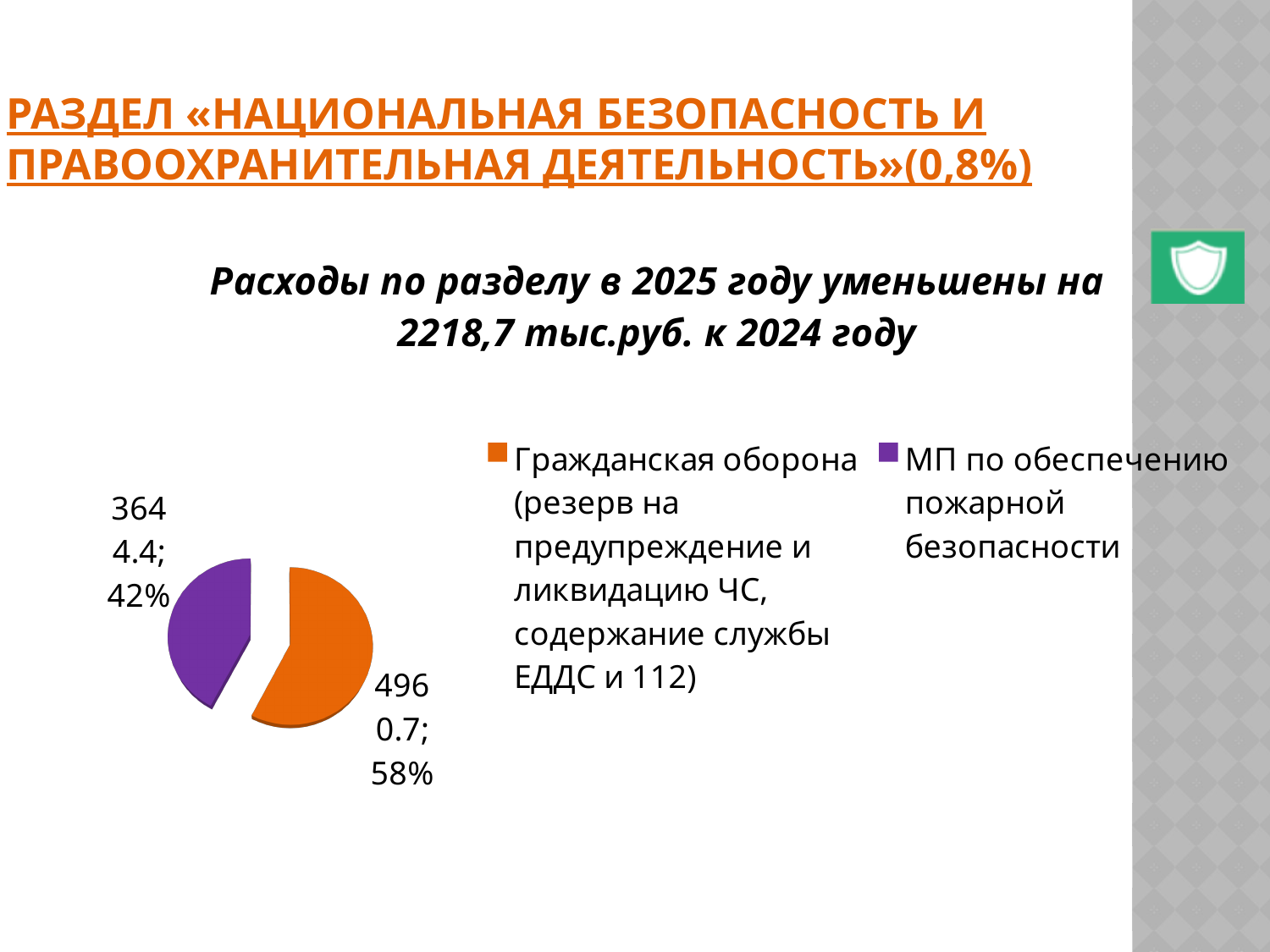
Which is larger: the value for 'Гражданская оборона' or for 'МП по обеспечению пожарной безопасности'? Гражданская оборона What value is shown for the slice 'Гражданская оборона (резерв на предупреждение и ликвидацию ЧС, содержание службы ЕДДС и 112)'? 4960.7 Which slice of the pie chart is the largest? Гражданская оборона (резерв на предупреждение и ликвидацию ЧС, содержание службы ЕДДС и 112) How many slices does the pie chart have? 2 What share of the pie does 'Гражданская оборона (резерв на предупреждение и ликвидацию ЧС, содержание службы ЕДДС и 112)' take? 58% What share of the pie does 'МП по обеспечению пожарной безопасности' take? 42% What colour is the slice for 'МП по обеспечению пожарной безопасности'? purple What value is shown for the slice 'МП по обеспечению пожарной безопасности'? 3644.4 What kind of chart is shown on the slide? pie chart What is the difference between the values for 'Гражданская оборона' and 'МП по обеспечению пожарной безопасности'? 1316.3 Which slice of the pie chart is the smallest? МП по обеспечению пожарной безопасности How many entries does the legend of the pie chart list? 2